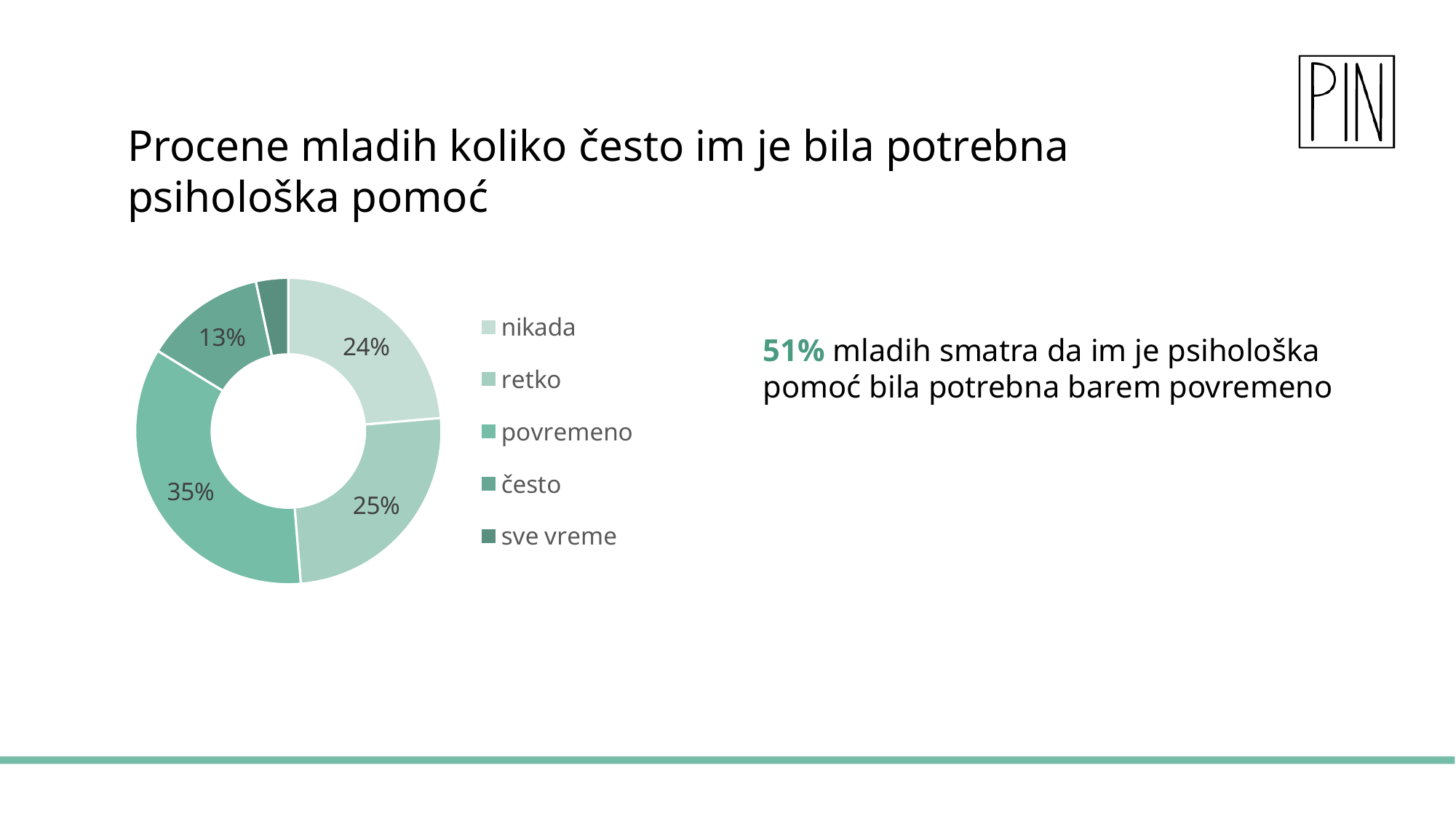
Which legend entry is shown in the darkest green colour? sve vreme How many categories does the legend list? 5 Which category has the smallest share of the chart? sve vreme Which is larger, the share for "retko" or the share for "nikada"? retko What is the combined share of "nikada" and "retko"? 49% What is the difference in percentage points between "povremeno" and "često"? 22 What percentage of young people answered "nikada"? 24% Which category has the largest share of the chart? povremeno What percentage of young people answered "retko"? 25% What kind of chart is shown on the slide? doughnut chart What percentage of young people answered "povremeno"? 35% What percentage of young people answered "često"? 13%